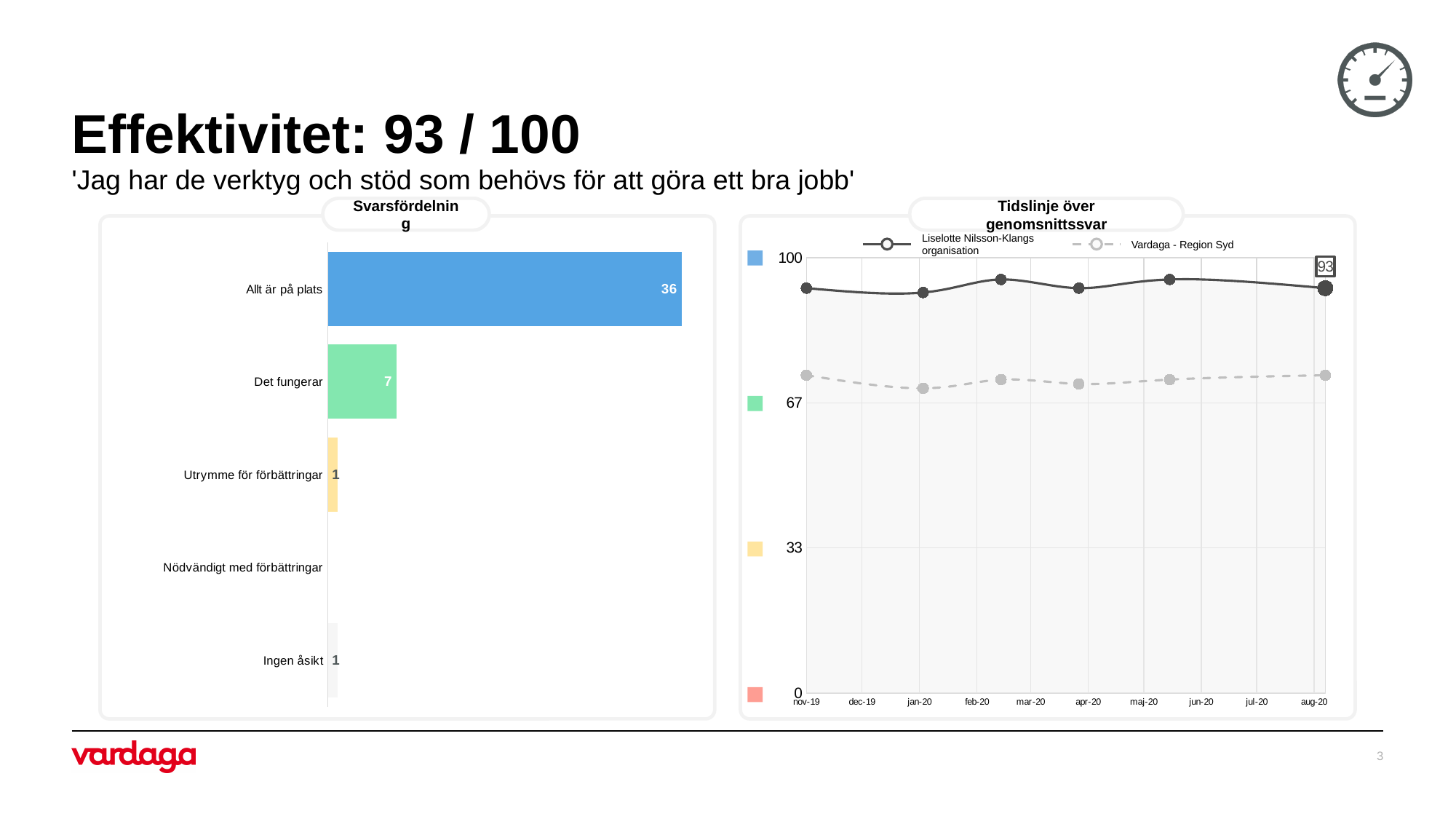
In the 'Tidslinje över genomsnittssvar' chart, which series is higher at aug-20? Liselotte Nilsson-Klangs organisation In the 'Tidslinje över genomsnittssvar' chart, is the value for Vardaga - Region Syd at aug-20 greater or less than 67? greater In the 'Tidslinje över genomsnittssvar' chart, what is the value for Liselotte Nilsson-Klangs organisation at aug-20? 93 In the Svarsfördelning chart, what is the value for 'Allt är på plats'? 36 In the Svarsfördelning chart, what is the difference between 'Allt är på plats' and 'Det fungerar'? 29 How many series does the legend of the 'Tidslinje över genomsnittssvar' chart list? 2 In the Svarsfördelning chart, which category has the highest value? Allt är på plats What is the title of the chart on the right side of the slide? Tidslinje över genomsnittssvar How many categories are listed in the Svarsfördelning chart? 5 In the Svarsfördelning chart, what is the value for 'Det fungerar'? 7 In the Svarsfördelning chart, which is larger: 'Det fungerar' or 'Utrymme för förbättringar'? Det fungerar What kind of chart is the Svarsfördelning chart? Bar chart